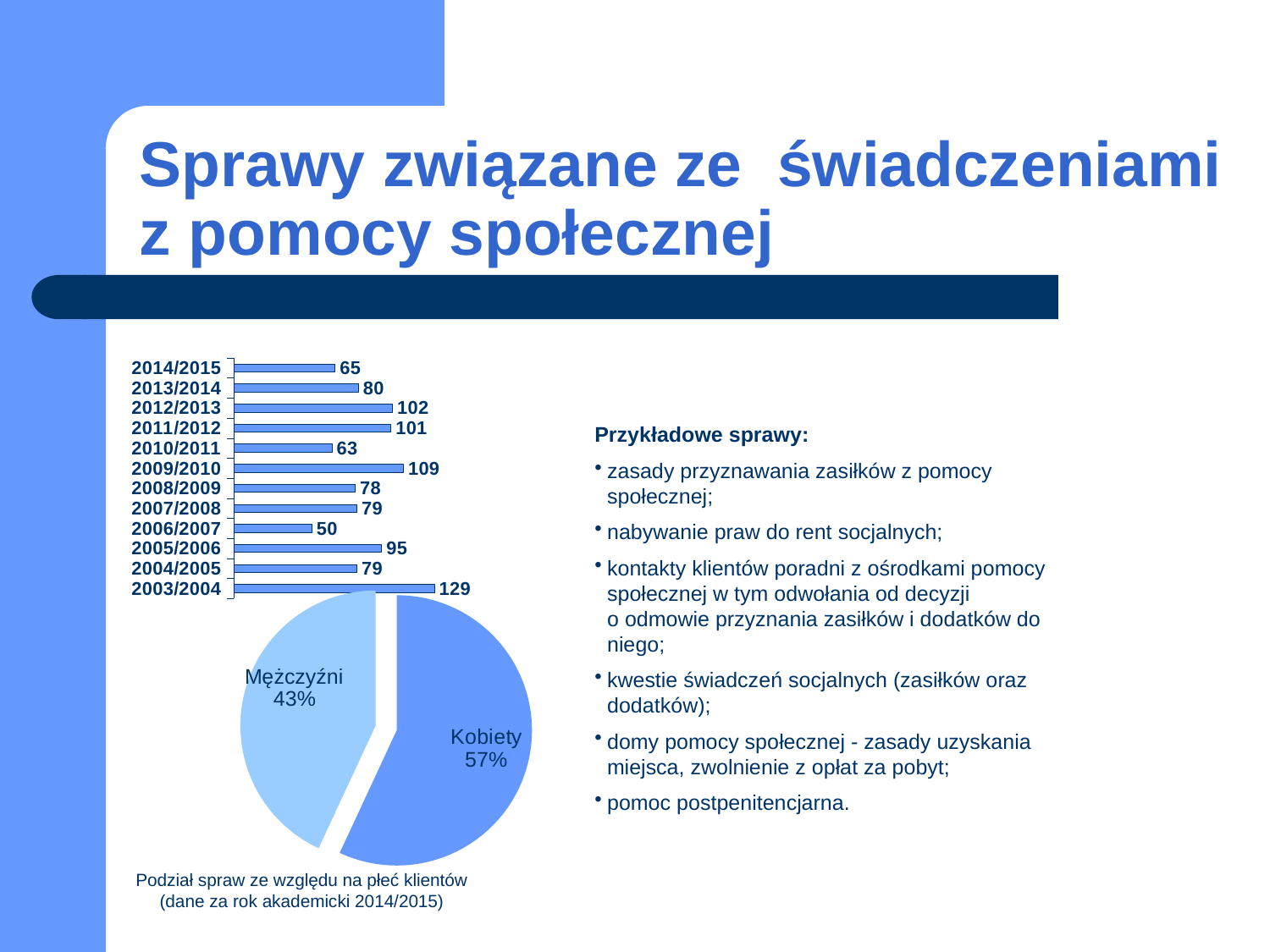
In the pie chart titled 'Podział spraw ze względu na płeć klientów', which slice is larger, Kobiety or Mężczyźni? Kobiety In the bar chart at the top left, which academic year has the highest value? 2003/2004 How many academic years are shown in the bar chart at the top left? 12 Which academic year does the pie chart titled 'Podział spraw ze względu na płeć klientów' cover? 2014/2015 In the pie chart titled 'Podział spraw ze względu na płeć klientów', what share is Mężczyźni? 43% In the bar chart at the top left, what is the value for 2014/2015? 65 In the bar chart at the top left, what is the difference between the values for 2009/2010 and 2010/2011? 46 In the bar chart at the top left, which is larger, the value for 2012/2013 or the value for 2013/2014? 2012/2013 What kind of chart is the chart at the top left of the slide? bar chart In the bar chart at the top left, what is the value for 2003/2004? 129 In the bar chart at the top left, which academic year has the lowest value? 2006/2007 In the pie chart titled 'Podział spraw ze względu na płeć klientów', what share is Kobiety? 57%